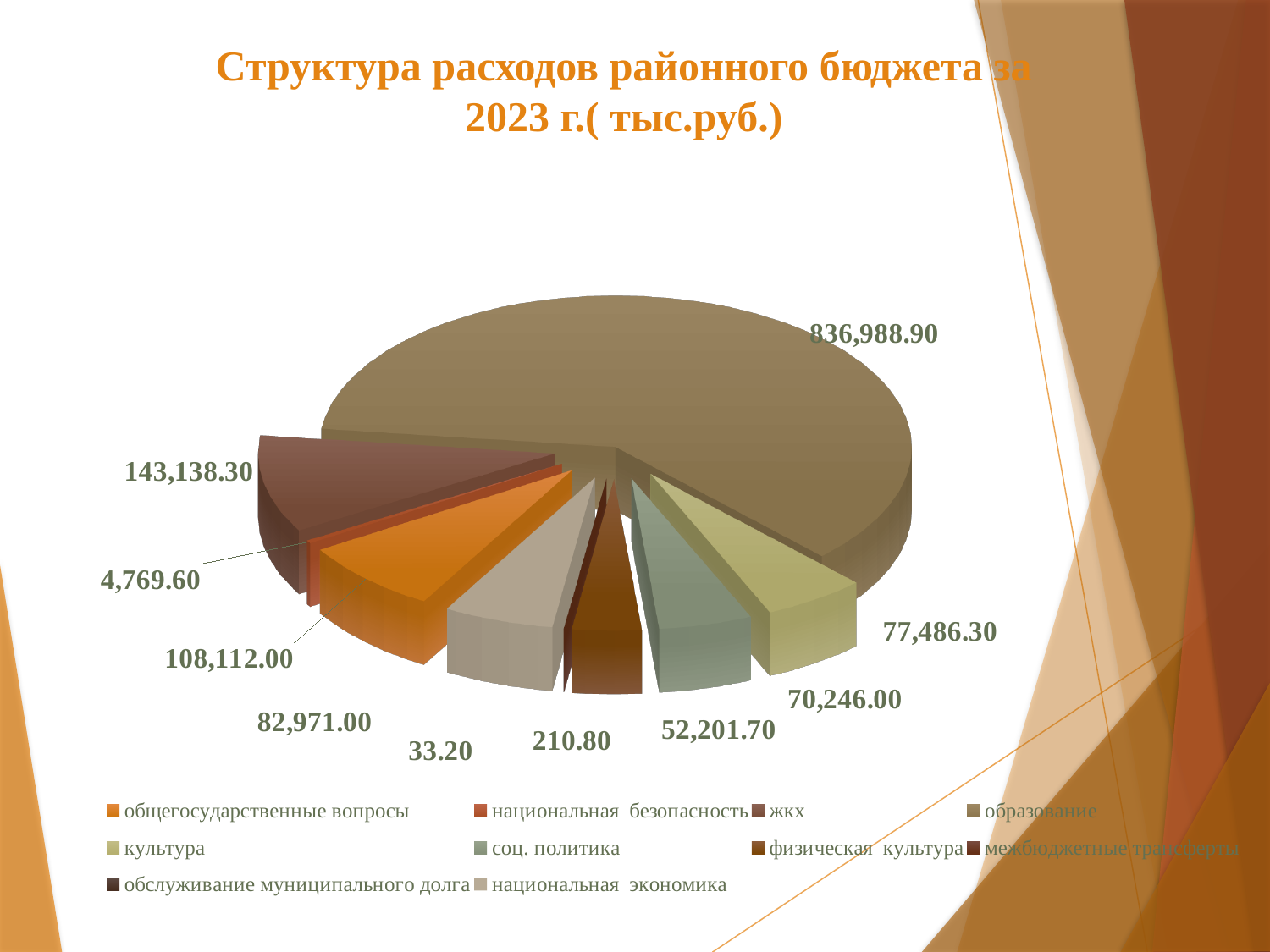
Which is larger, the value for общегосударственные вопросы or the value for национальная экономика? общегосударственные вопросы What is the value for образование? 836,988.90 Which category has the largest share of the pie? образование What is the value for национальная экономика? 82,971.00 What is the smallest value shown on the chart? 33.20 What is the difference between the values for образование and жкх? 693,850.60 What is the value for национальная безопасность? 4,769.60 How many categories does the legend list? 10 What is the value for жкх? 143,138.30 What type of chart is shown on the slide? Pie chart What is the title of the chart? Структура расходов районного бюджета за 2023 г.( тыс.руб.) What is the value for общегосударственные вопросы? 108,112.00